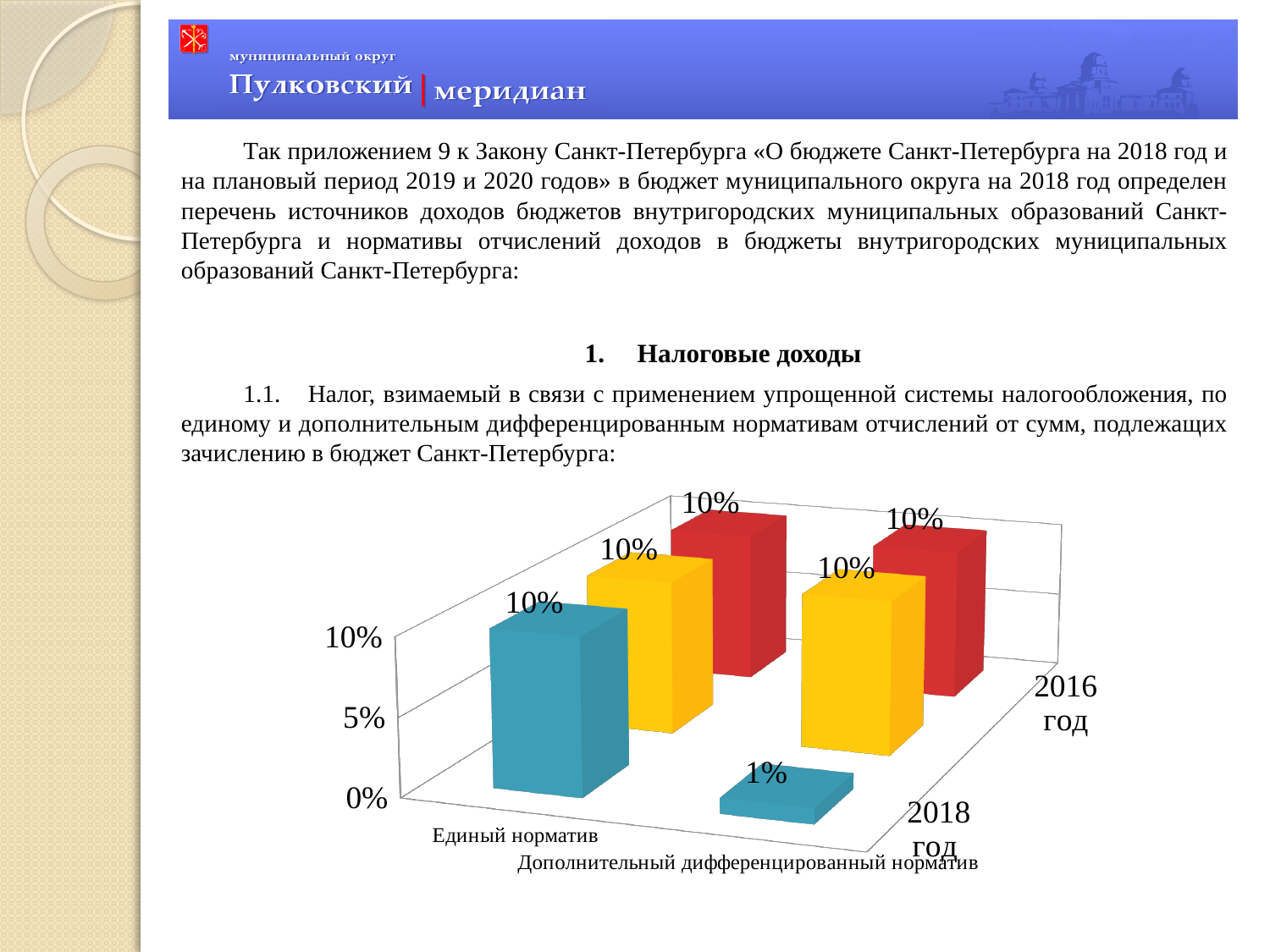
Is the value for Дополнительный дифференцированный норматив in 2018 год greater or less than 5%? less How many bars are plotted on the chart in total? 6 What kind of chart is shown on the slide? bar chart In 2018 год, which is larger: Единый норматив or Дополнительный дифференцированный норматив? Единый норматив How many categories are shown along the x axis of the chart? 2 What is the value for Единый норматив in 2018 год? 10% What is the difference between Единый норматив and Дополнительный дифференцированный норматив in 2018 год? 9% What is the lowest value shown on the chart? 1% What is the value for Дополнительный дифференцированный норматив in 2016 год? 10% What is the value for Единый норматив in 2016 год? 10% What is the highest value labelled on the vertical axis of the chart? 10% What is the value for Дополнительный дифференцированный норматив in 2018 год? 1%